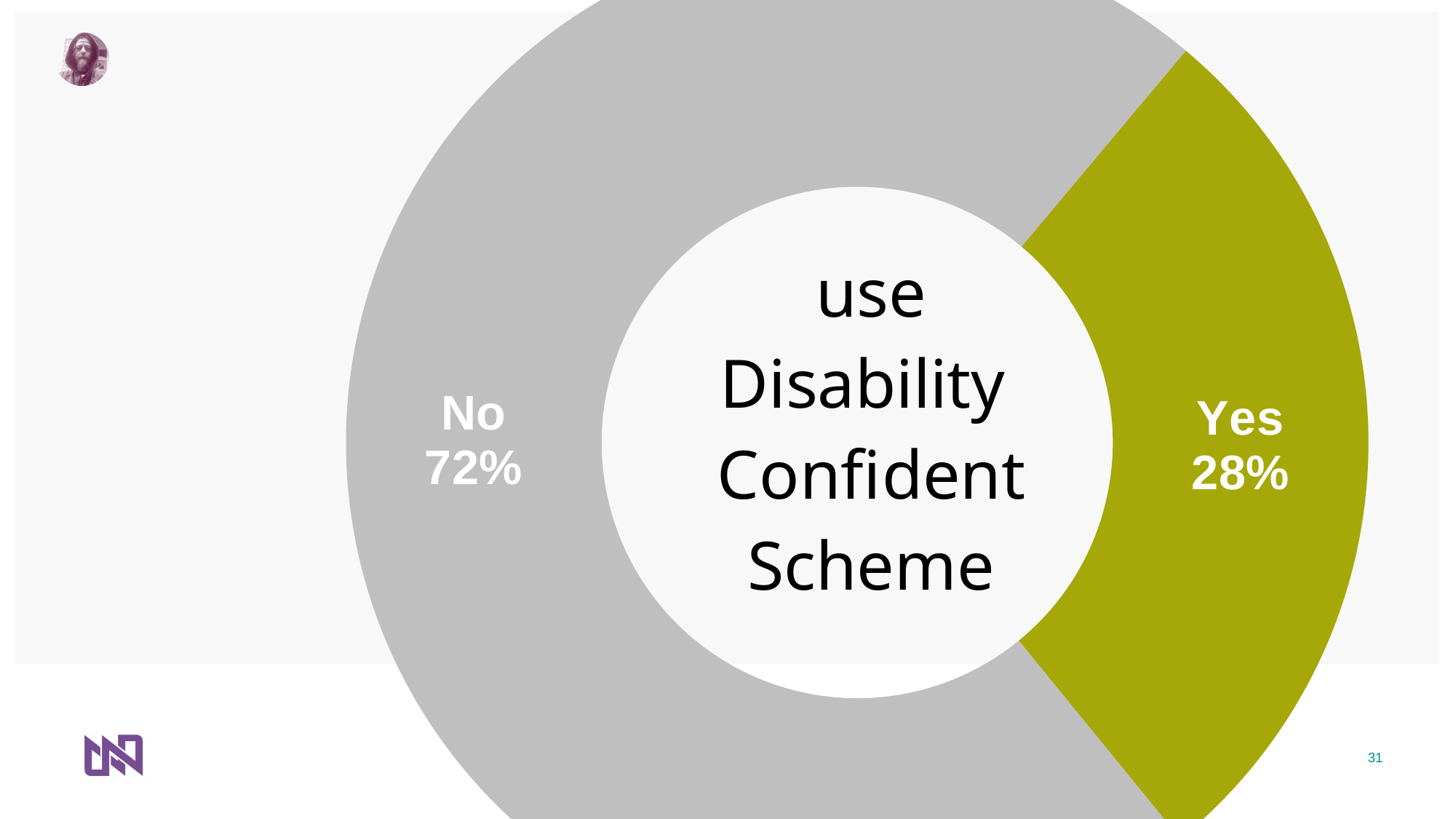
Which is larger, the "Yes" share or the "No" share? No What colour is the "Yes" segment of the chart? Green What is the difference in percentage points between the "No" and "Yes" shares? 44 How many categories are shown in the chart? 2 What share of the chart does the "Yes" slice represent? 28% Which category has the largest share of the chart? No What percentage of respondents answered "No" to using the Disability Confident Scheme? 72% What kind of chart is shown on the slide? Doughnut chart What percentage of respondents answered "Yes" to using the Disability Confident Scheme? 28% What text appears in the centre of the chart? use Disability Confident Scheme Which category has the smallest share of the chart? Yes